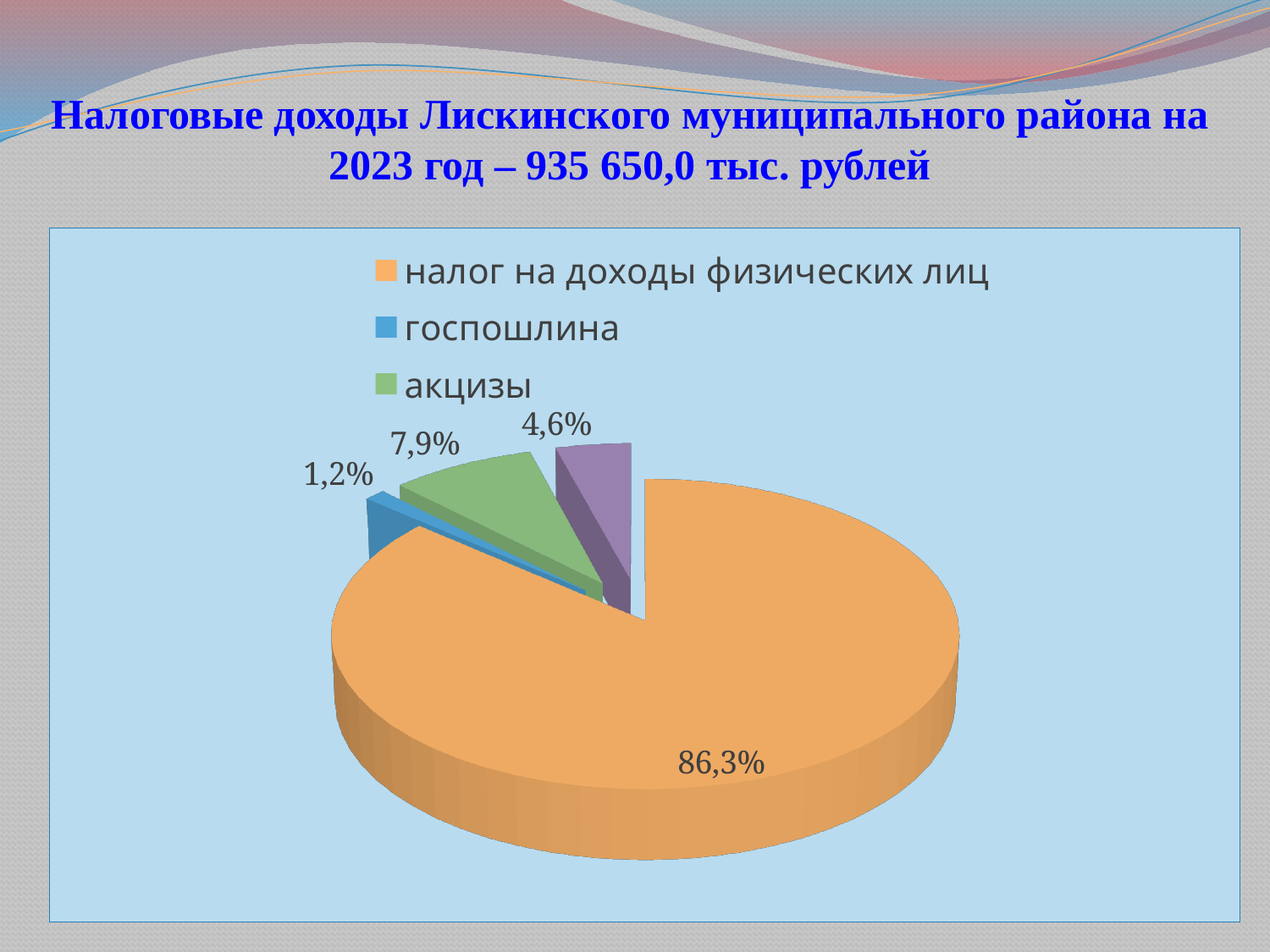
How many slices does the pie chart have? 4 What share of the pie does налог на доходы физических лиц account for? 86,3% What is the difference between the shares of акцизы and госпошлина? 6,7% What is the value shown for акцизы? 7,9% Which category has the smallest slice of the pie? госпошлина How many entries does the legend list? 3 What is the value shown for госпошлина? 1,2% What colour is the slice for налог на доходы физических лиц? orange Which category has the largest slice of the pie? налог на доходы физических лиц Which is larger, the slice for акцизы or the slice for госпошлина? акцизы What kind of chart is shown on the slide? pie chart By how many percentage points does налог на доходы физических лиц exceed акцизы? 78,4%